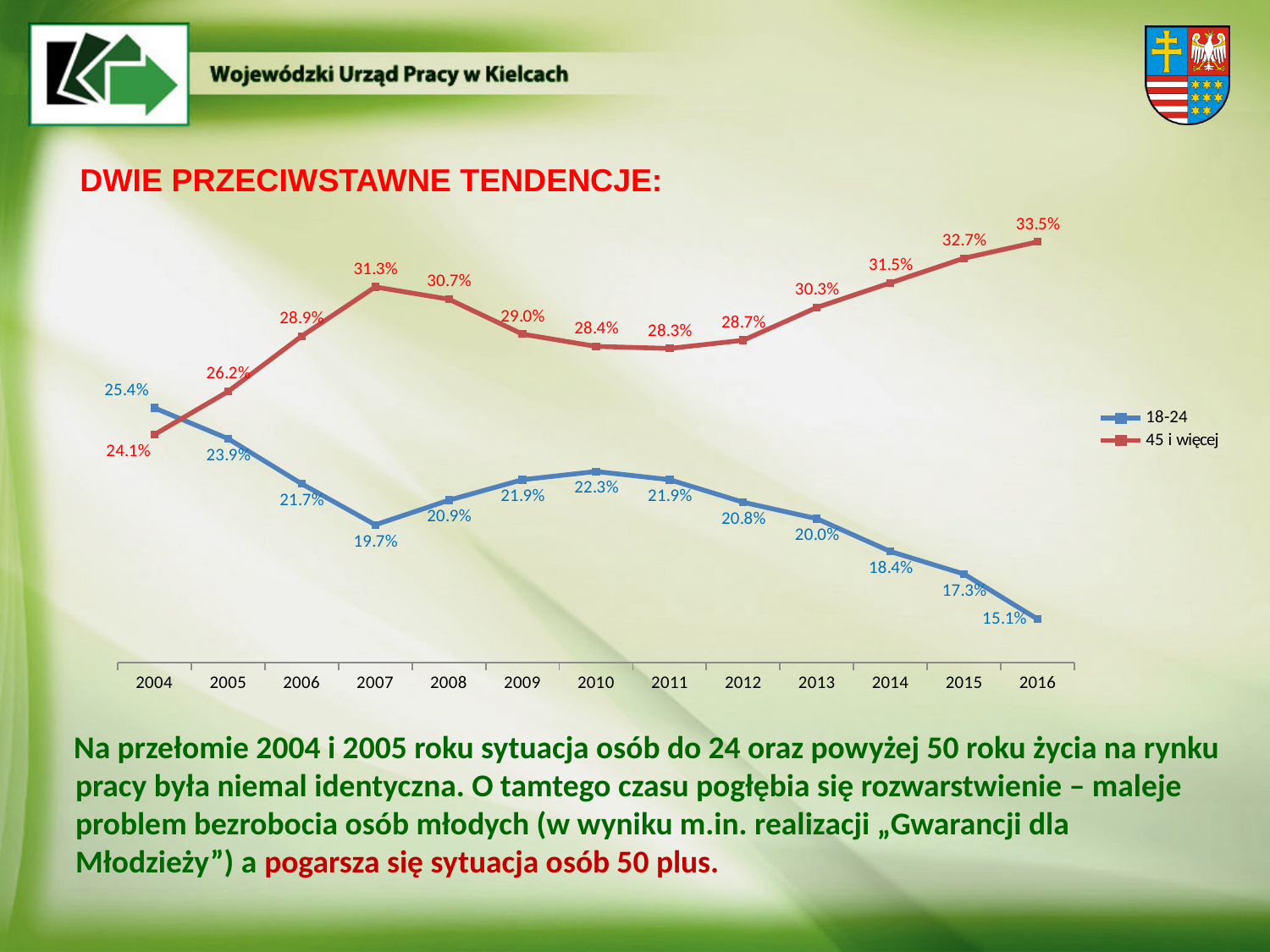
How many series does the legend list? 2 What colour is the line for the 45 i więcej series? Red In which year is the 18-24 series at its lowest? 2016 Which series has the larger value in 2004? 18-24 What is the difference between the 45 i więcej and 18-24 values in 2016? 18.4 percentage points What is the value for the 45 i więcej series in 2016? 33.5% What is the value for the 18-24 series in 2010? 22.3% What type of chart is shown on the slide? Line chart How many years are shown on the x axis? 13 Does the 18-24 series generally rise or fall from 2010 to 2016? Fall In which year is the 45 i więcej series at its highest? 2016 What is the value for the 18-24 series in 2007? 19.7%